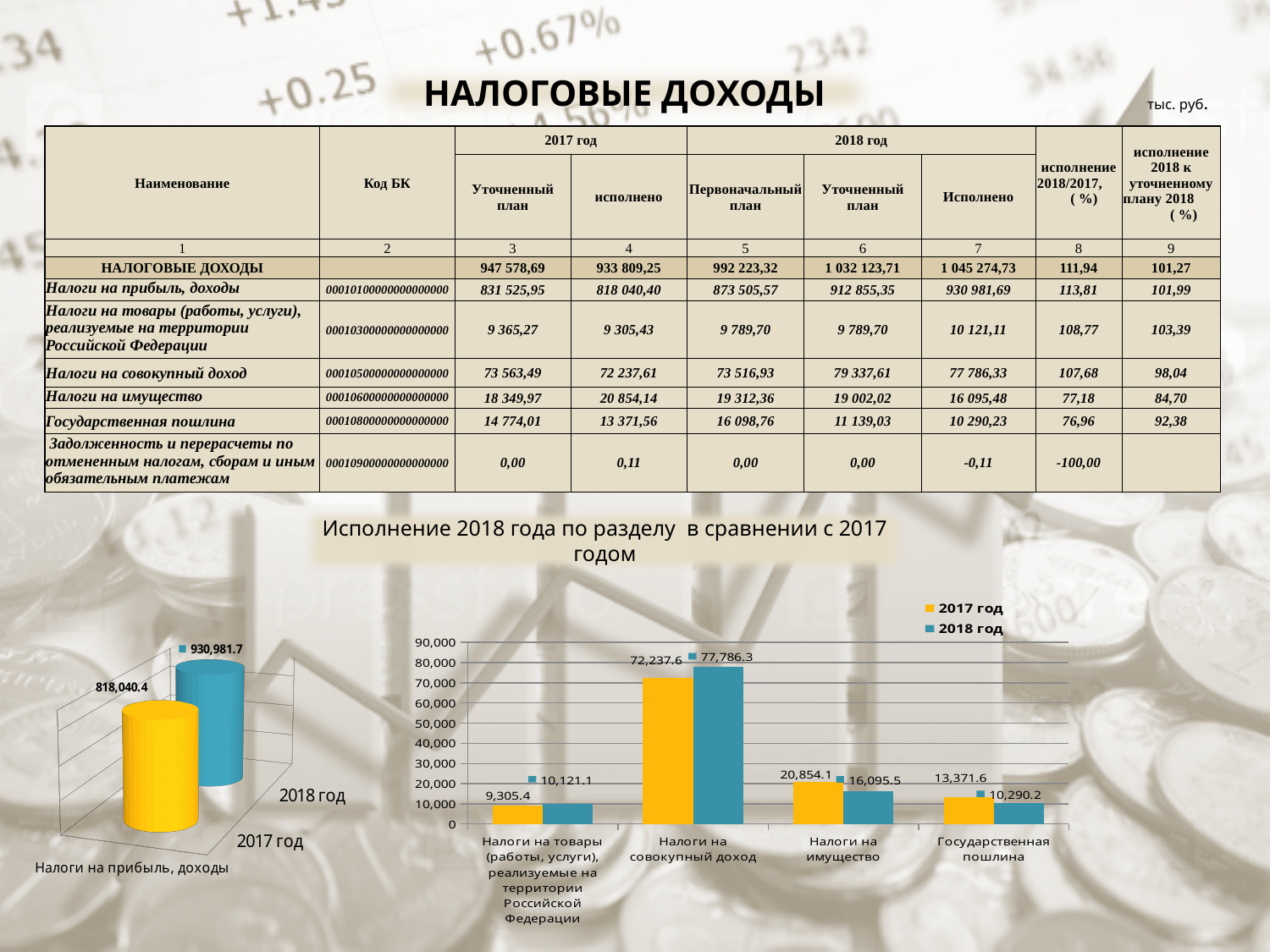
In the left-hand chart (Налоги на прибыль, доходы), what is the value for 2018 год? 930,981.7 In the right-hand bar chart, what is the 2017 год value for Налоги на имущество? 20,854.1 In the right-hand bar chart, which category has the lowest 2018 год value? Налоги на товары (работы, услуги), реализуемые на территории Российской Федерации In the right-hand bar chart, what is the 2018 год value for Налоги на совокупный доход? 77,786.3 How many series does the legend of the right-hand bar chart list? 2 In the right-hand bar chart, what is the difference between the 2018 год and 2017 год values for Налоги на совокупный доход? 5,548.7 In the right-hand bar chart, which category has the highest 2017 год value? Налоги на совокупный доход In the right-hand bar chart, which is larger for Налоги на имущество: the 2017 год value or the 2018 год value? 2017 год In the left-hand chart (Налоги на прибыль, доходы), what is the difference between the 2018 год and 2017 год values? 112,941.3 In the right-hand bar chart, what is the 2018 год value for Государственная пошлина? 10,290.2 How many categories are shown on the x axis of the right-hand bar chart? 4 What is the title of the right-hand chart? Исполнение 2018 года по разделу в сравнении с 2017 годом